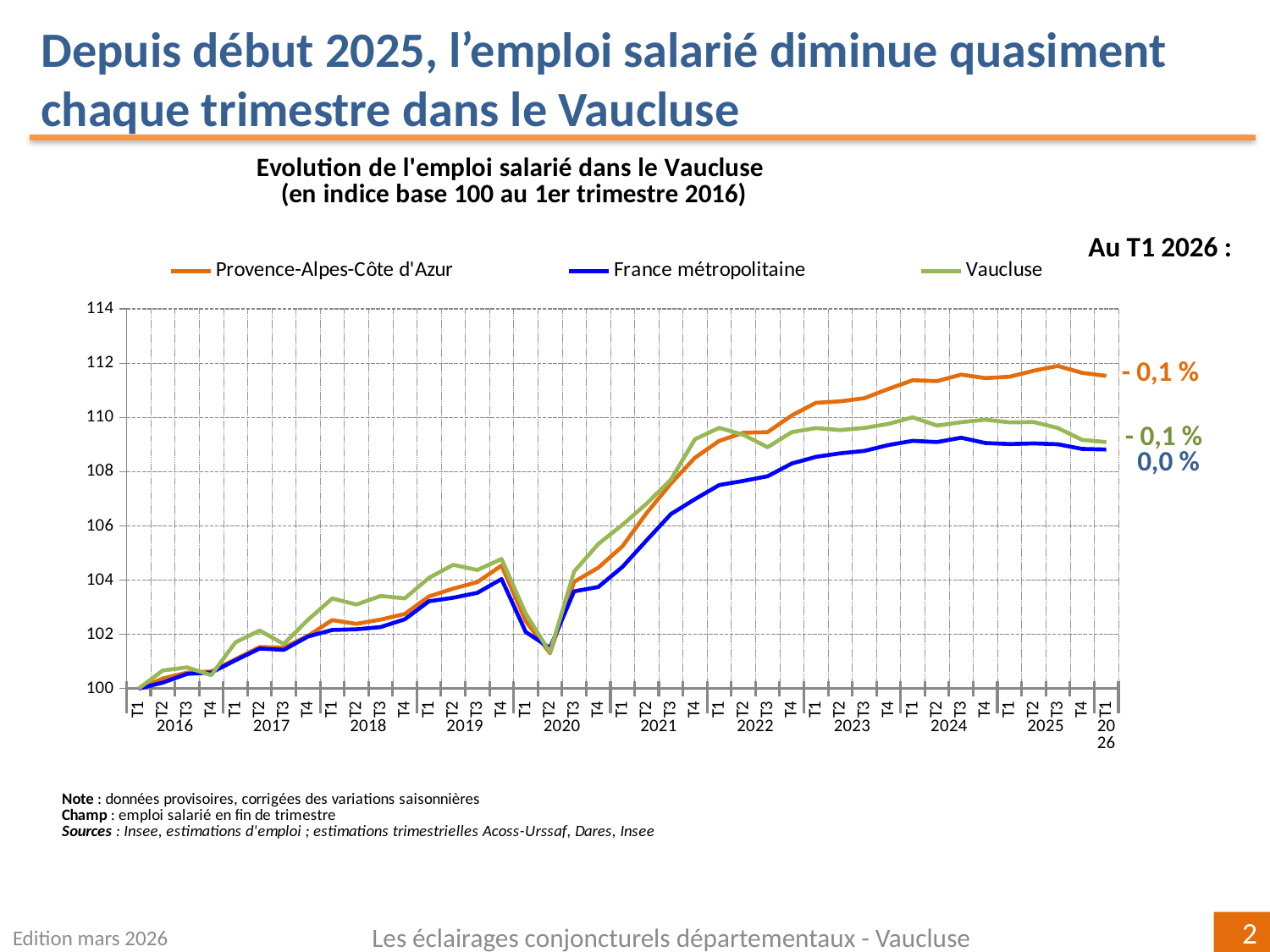
What is the title of the chart? Evolution de l'emploi salarié dans le Vaucluse (en indice base 100 au 1er trimestre 2016) At T1 2026, which is higher: Provence-Alpes-Côte d'Azur or France métropolitaine? Provence-Alpes-Côte d'Azur Which series has the highest index value at T1 2026? Provence-Alpes-Côte d'Azur What quarterly change is annotated for Provence-Alpes-Côte d'Azur at T1 2026? - 0,1 % What quarterly change is annotated for France métropolitaine at T1 2026? 0,0 % Overall, do the index values rise or fall between T1 2016 and T1 2025? rise Is the value for France métropolitaine at T1 2026 greater or less than 110? less What kind of chart is shown on the slide? line chart Which series is shown in blue in the legend? France métropolitaine Is the value for Provence-Alpes-Côte d'Azur at T3 2025 greater or less than 110? greater What is the index value of all three series at T1 2016? 100 How many series does the legend list? 3